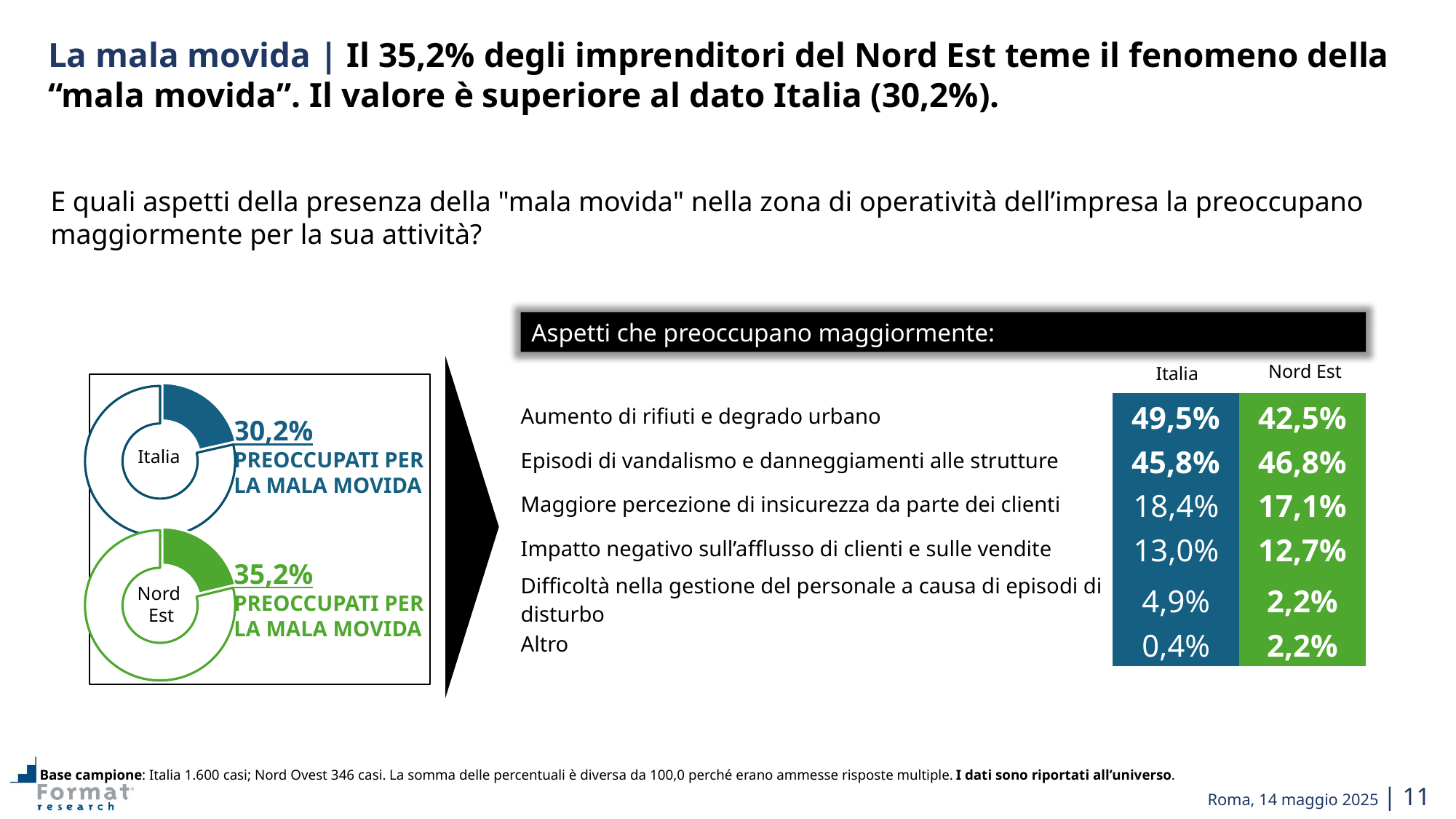
In the Nord Est donut chart, what share of entrepreneurs are 'preoccupati per la mala movida'? 35,2% What colour is the highlighted slice in the Italia donut chart? Blue What colour is the highlighted slice in the Nord Est donut chart? Green By how many percentage points does the Nord Est share of worried entrepreneurs (35,2%) exceed the Italia share (30,2%)? 5,0 percentage points What kind of chart is used to show the share of entrepreneurs worried about 'mala movida' for Italia and Nord Est? Donut (pie) chart How many donut charts are shown on the left side of the slide? 2 In the table 'Aspetti che preoccupano maggiormente', which aspect has the highest Nord Est value? Episodi di vandalismo e danneggiamenti alle strutture In the table 'Aspetti che preoccupano maggiormente', which aspect has the lowest Italia value? Altro Which donut chart shows the larger share of entrepreneurs worried about 'mala movida', Italia or Nord Est? Nord Est In the Italia donut chart, what share of entrepreneurs are 'preoccupati per la mala movida'? 30,2% In the table 'Aspetti che preoccupano maggiormente', what is the Nord Est value for 'Episodi di vandalismo e danneggiamenti alle strutture'? 46,8% In the table 'Aspetti che preoccupano maggiormente', what is the Italia value for 'Aumento di rifiuti e degrado urbano'? 49,5%